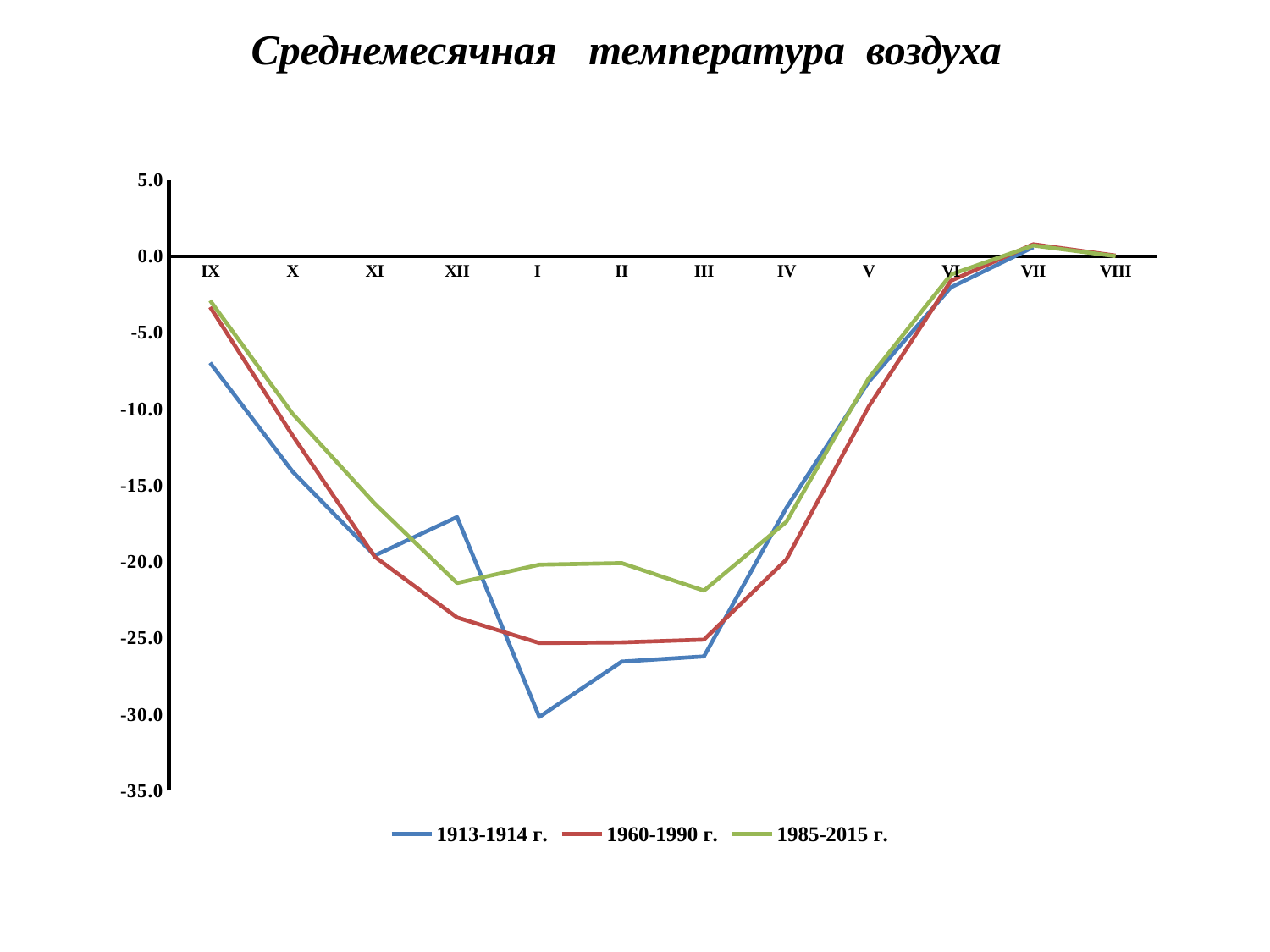
How many months are plotted along the x axis? 12 Do the values of the 1913-1914 г. series rise or fall from month IX to month I? fall Is the value for 1913-1914 г. in month I greater or less than -25.0? less What kind of chart is shown on the slide? line chart In month XII, which series has the higher value: 1913-1914 г. or 1960-1990 г.? 1913-1914 г. Is the value for 1985-2015 г. in month I greater or less than -25.0? greater In which month does the 1913-1914 г. series reach its lowest value? I In month I, which series has the higher value: 1985-2015 г. or 1913-1914 г.? 1985-2015 г. How many series does the legend list? 3 Is the value for 1913-1914 г. in month IX greater or less than -5.0? less What is the title of the chart? Среднемесячная температура воздуха Do the values of the 1960-1990 г. series rise or fall from month I to month VII? rise